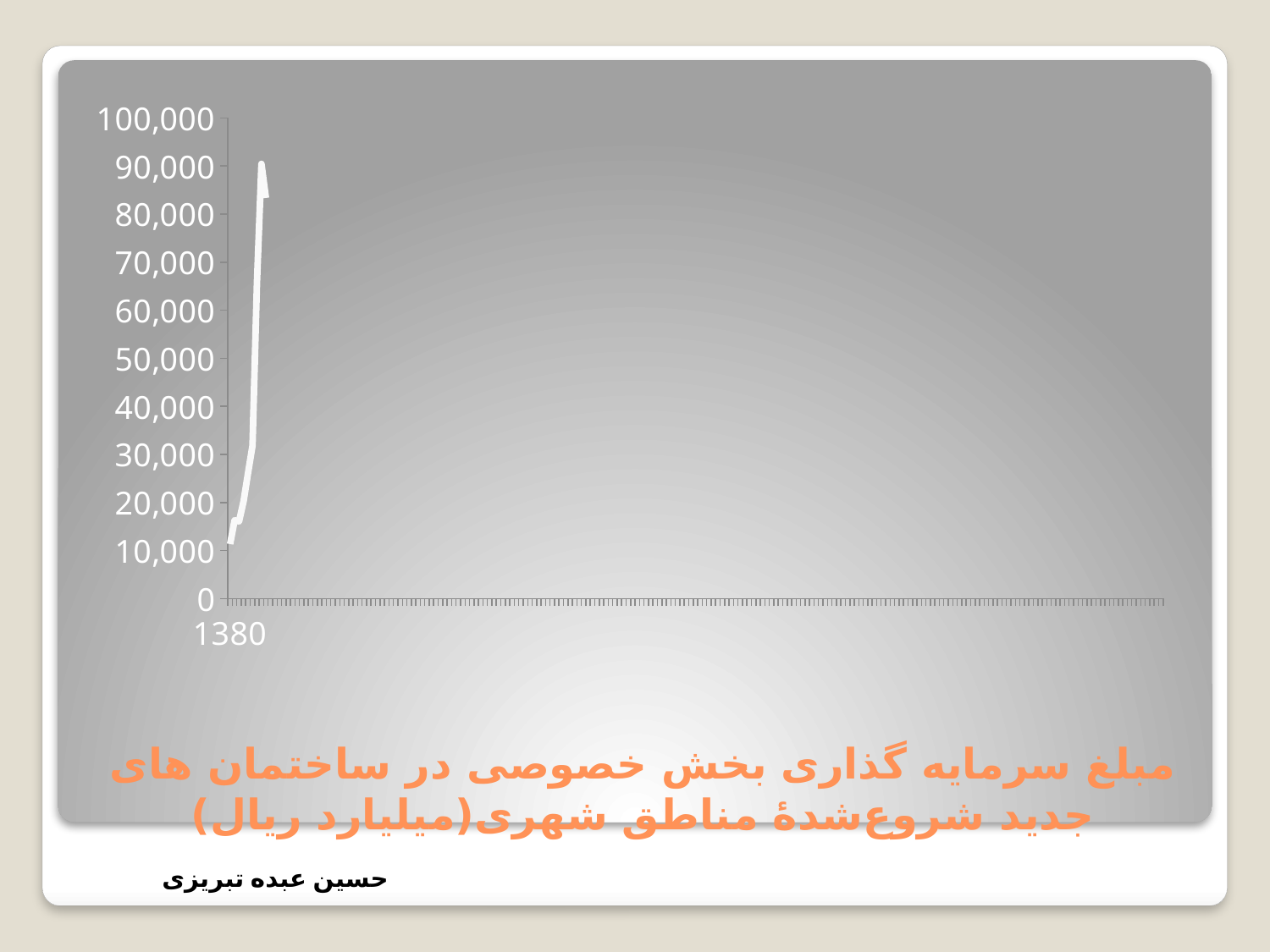
What kind of chart is shown on the slide? line chart How many lines are plotted on the chart? 1 Is the highest point of the line greater or less than 80,000? greater Does the plotted line rise or fall as it moves along the x axis? rises What is the highest value shown on the y axis? 100,000 Is the starting value of the line greater or less than 20,000? less Is the highest point of the line greater or less than 100,000? less What is the only year label shown on the x axis? 1380